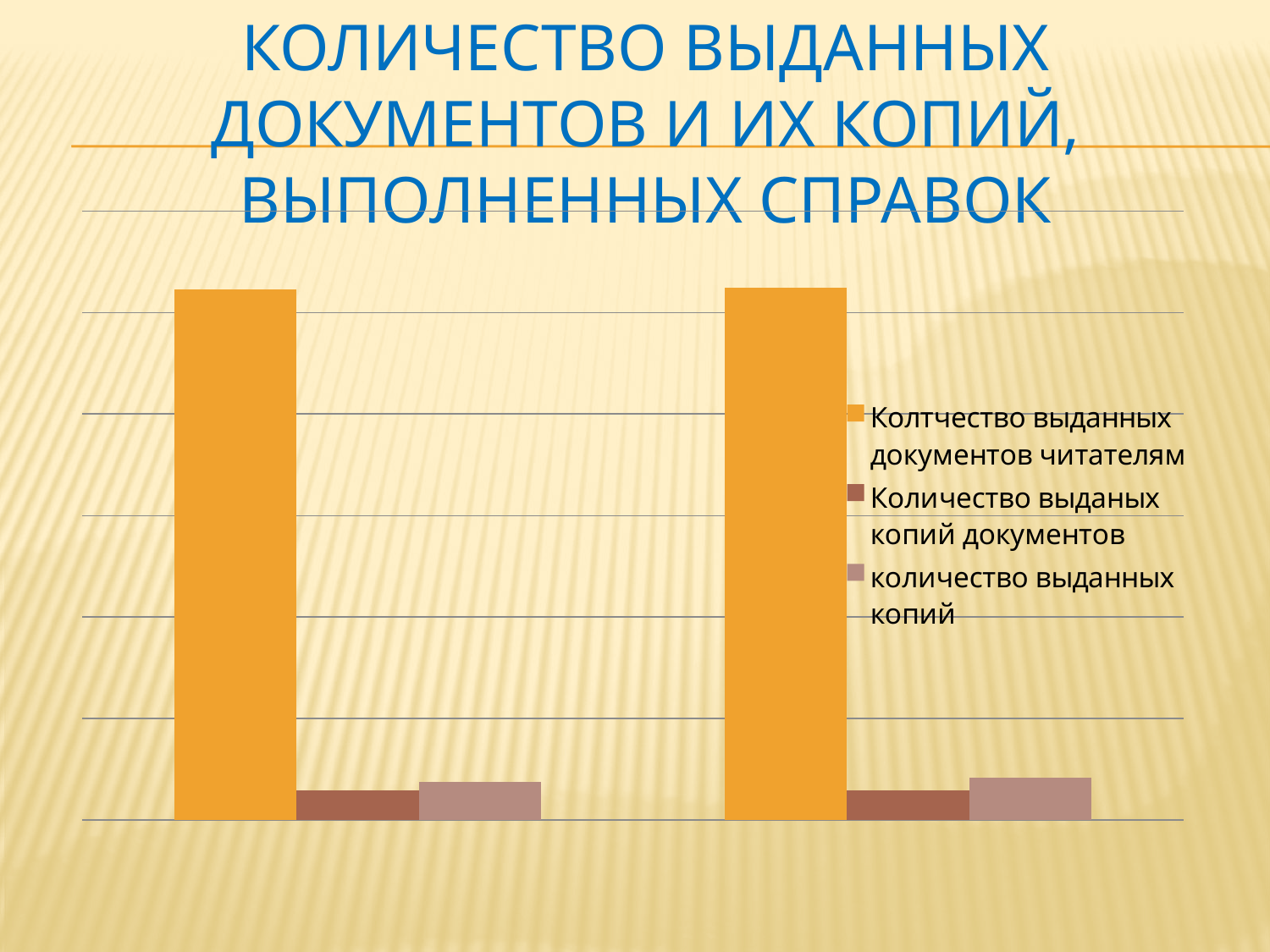
What is the title of the slide containing the chart? Количество выданных документов и их копий, выполненных справок What colour are the bars for the series 'Колтчество выданных документов читателям'? orange Which series has the shortest bars in the chart? Количество выданых копий документов In the left group of bars, which is larger: the bar for 'Колтчество выданных документов читателям' or the bar for 'Количество выданых копий документов'? Колтчество выданных документов читателям Which series has the tallest bars in the chart? Колтчество выданных документов читателям How many series does the legend list? 3 How many groups of bars are plotted in the chart? 2 What kind of chart is shown on the slide? bar chart In the right group of bars, which is larger: the bar for 'количество выданных копий' or the bar for 'Количество выданых копий документов'? количество выданных копий